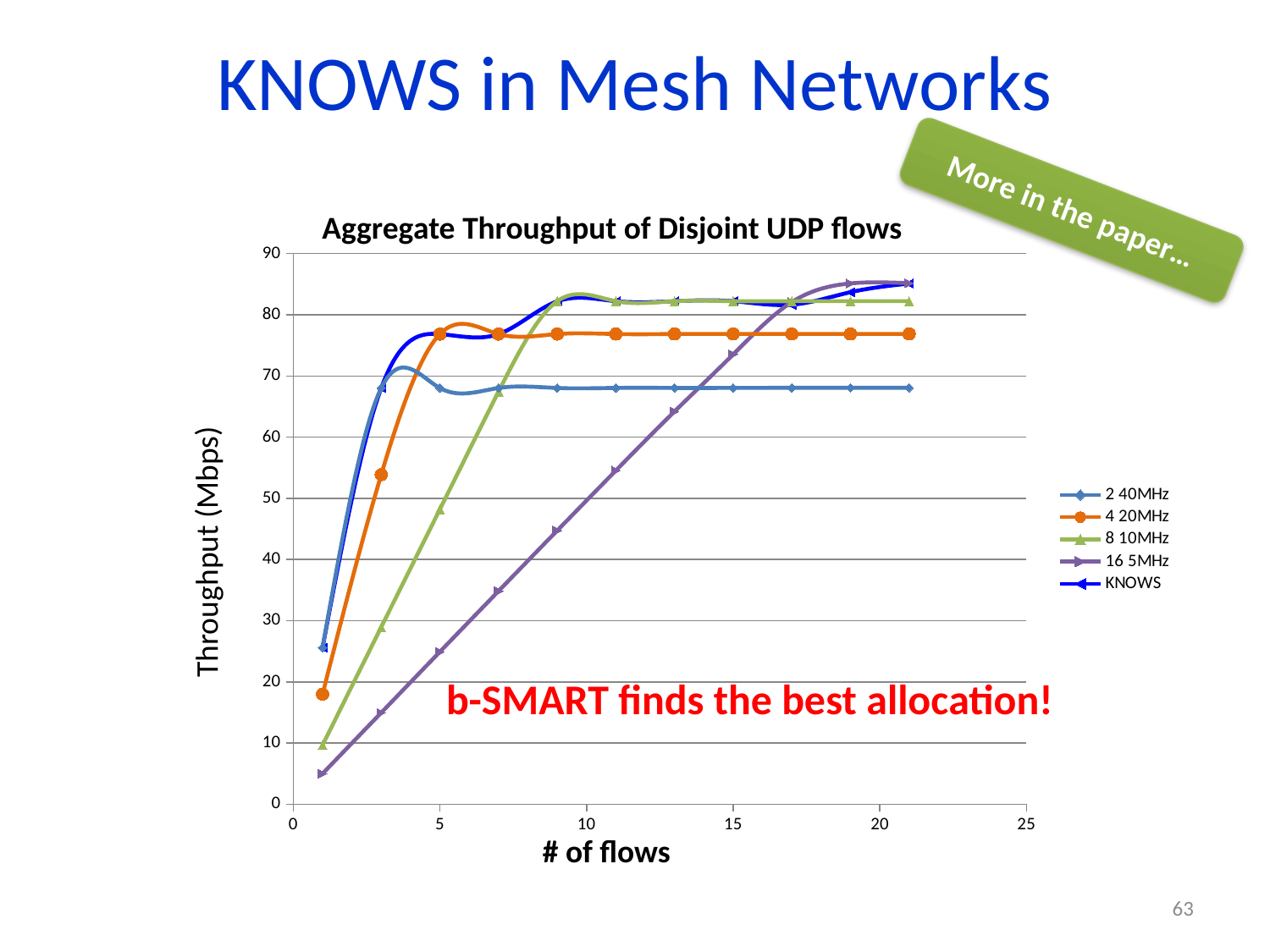
What is the title of the chart? Aggregate Throughput of Disjoint UDP flows Is the value for 4 20MHz at 21 flows greater or less than 80? less At 21 flows, which series has the lowest throughput? 2 40MHz At 1 flow, which is larger: 2 40MHz or 16 5MHz? 2 40MHz How many series does the legend list? 5 Does the 16 5MHz series rise or fall as the number of flows increases? rise What kind of chart is shown on the slide? line chart What is the label of the y axis? Throughput (Mbps) Is the value for 16 5MHz at 11 flows greater or less than 50? greater Is the value for 16 5MHz at 1 flow greater or less than 10? less